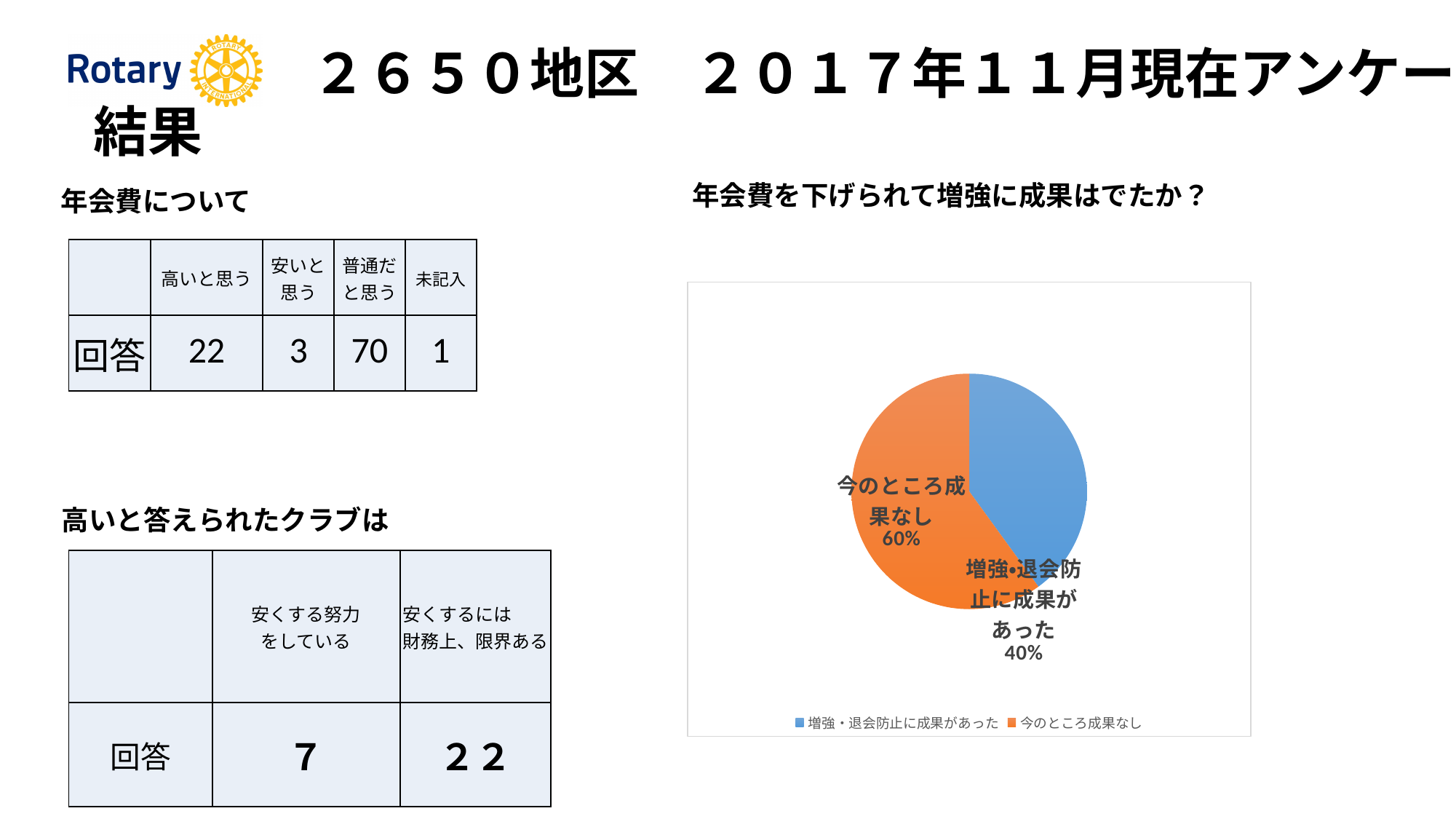
What is the heading above the pie chart? 年会費を下げられて増強に成果はでたか？ In the pie chart, what share is labelled for 増強・退会防止に成果があった? 40% What colour is the 今のところ成果なし slice in the pie chart? Orange What kind of chart is shown on the slide? Pie chart How many slices does the pie chart have? 2 In the pie chart, what share is labelled for 今のところ成果なし? 60% What is the difference in percentage points between the 今のところ成果なし slice and the 増強・退会防止に成果があった slice? 20 percentage points Which is larger in the pie chart: 今のところ成果なし or 増強・退会防止に成果があった? 今のところ成果なし Which slice of the pie chart is the smallest? 増強・退会防止に成果があった Which slice of the pie chart is the largest? 今のところ成果なし Is the share for 増強・退会防止に成果があった greater or less than 50%? less How many entries does the pie chart's legend list? 2